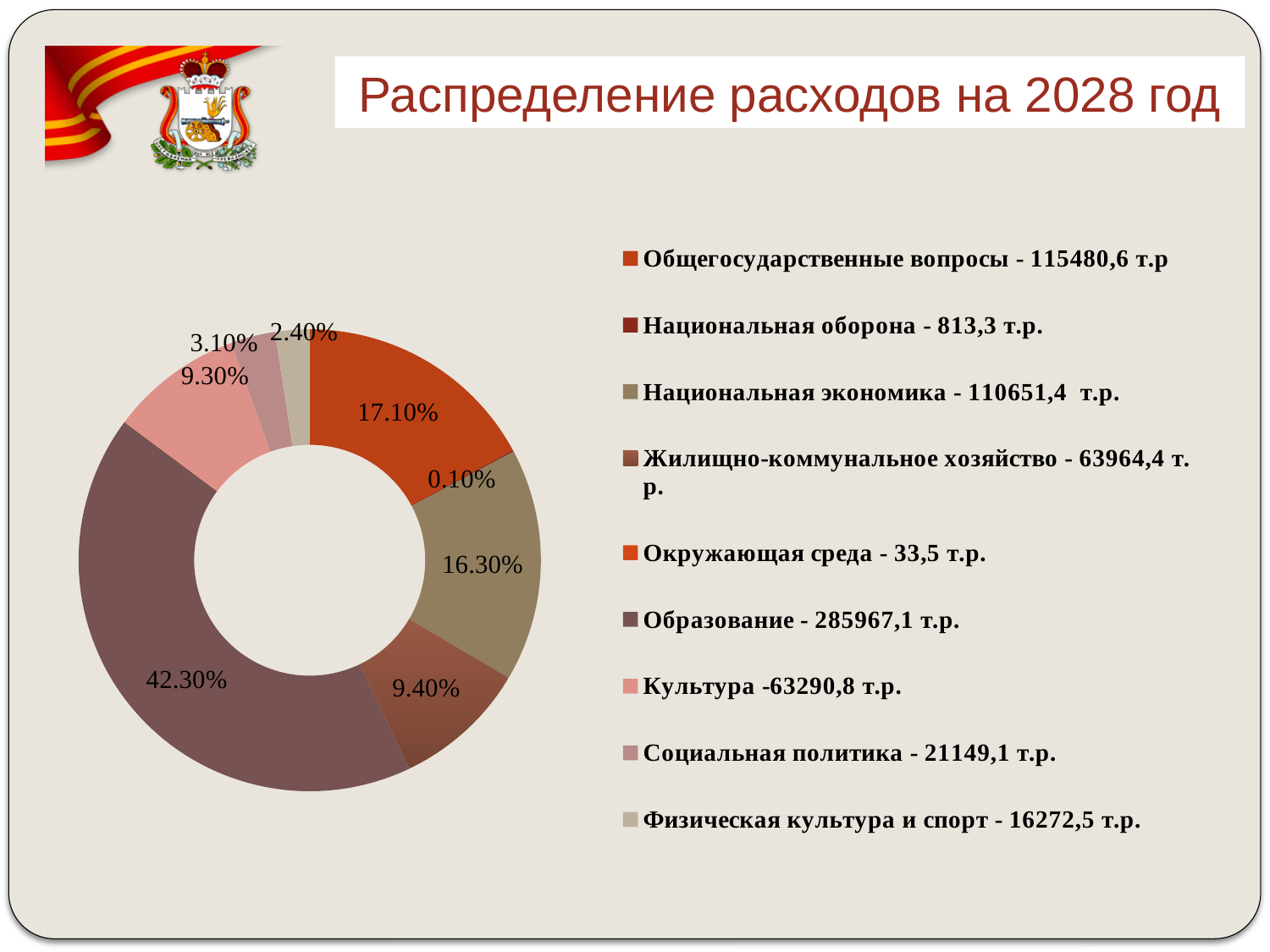
What share of expenditures is labelled for Образование? 42.30% What is the title of the chart on the slide? Распределение расходов на 2028 год What type of chart is shown on the slide? Doughnut (pie) chart Which has the larger share: Национальная экономика or Жилищно-коммунальное хозяйство? Национальная экономика How many categories does the legend list? 9 Which category has the smallest amount according to the legend? Окружающая среда - 33,5 т.р. What share is labelled for Физическая культура и спорт? 2.40% Which category has the largest share of the chart? Образование What share is labelled for Культура? 9.30% What share is labelled for Национальная экономика? 16.30% What is the difference in percentage points between the shares of Образование and Общегосударственные вопросы? 25.20% What share is labelled for Общегосударственные вопросы? 17.10%